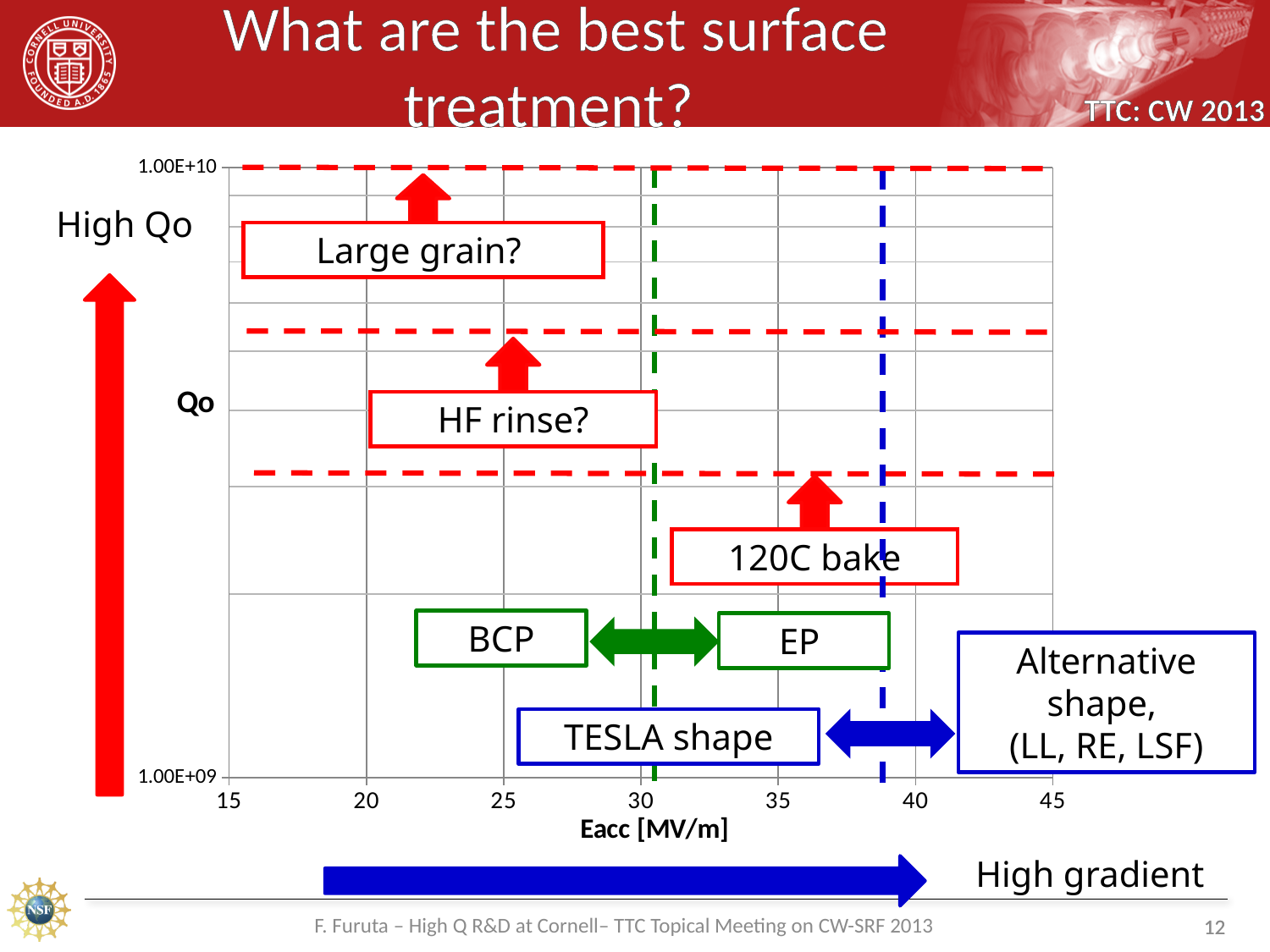
What is the label on the y axis of the chart? Qo Is the blue dashed vertical line on the chart at an Eacc greater or less than 35? greater What is the largest Eacc value labelled on the x axis of the chart? 45 Is the blue dashed vertical line on the chart at an Eacc greater or less than 40? less Is the green dashed vertical line on the chart at an Eacc greater or less than 35? less What is the label on the x axis of the chart? Eacc [MV/m] How many tick labels are shown on the x axis of the chart? 7 What is the highest value labelled on the y axis of the chart? 1.00E+10 Which of the two boxes BCP and EP is placed at the higher Eacc on the chart? EP What is the lowest value labelled on the y axis of the chart? 1.00E+09